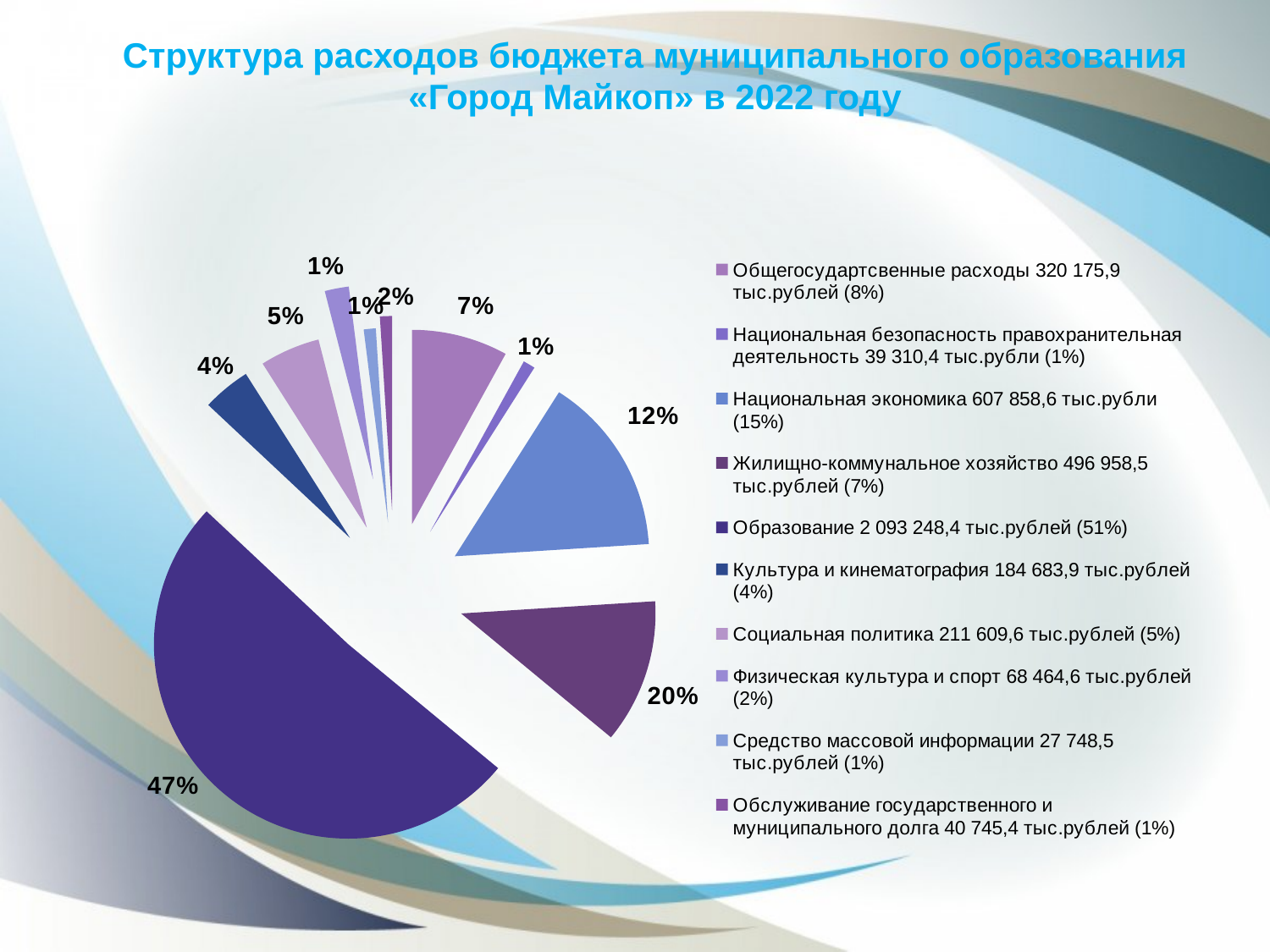
What year does the chart title refer to? 2022 Which category has the largest slice in the pie chart? Образование What kind of chart is shown on the slide? pie chart According to the legend, what amount in тыс.рублей is given for Образование? 2 093 248,4 тыс.рублей What percentage label is printed on the slice for Национальная экономика? 12% Which slice is larger in the pie chart: Национальная экономика or Жилищно-коммунальное хозяйство? Жилищно-коммунальное хозяйство What percentage label is printed on the slice for Жилищно-коммунальное хозяйство? 20% How many categories does the legend of the pie chart list? 10 What is the difference between the percentage labels on the Образование slice and the Жилищно-коммунальное хозяйство slice? 27% What percentage label is printed on the slice for Социальная политика? 5% What percentage label is printed on the largest slice of the pie chart? 47% What percentage label is printed on the slice for Культура и кинематография? 4%